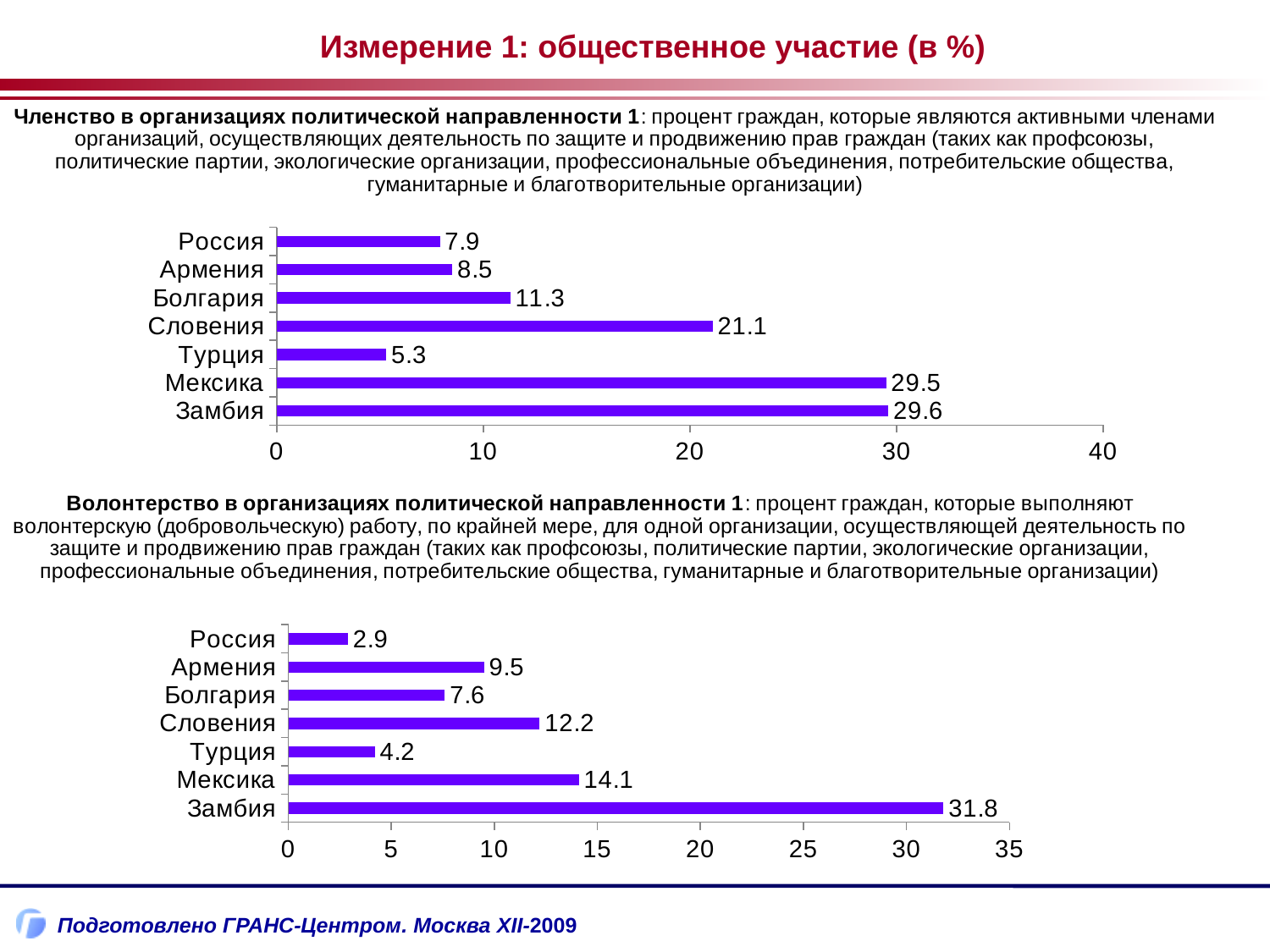
In the bottom chart (volunteering in political organizations), which country has the lowest value? Россия What is the maximum value shown on the x axis of the top chart (membership in political organizations)? 40 In the top chart (membership in political organizations), what is the difference between the values for Словения and Болгария? 9.8 In the top chart (membership in political organizations), which is larger: the value for Армения or the value for Россия? Армения In the bottom chart (volunteering in political organizations), what is the value for Мексика? 14.1 In the top chart (membership in political organizations), how many countries are shown? 7 In the bottom chart (volunteering in political organizations), which country has the highest value? Замбия In the bottom chart (volunteering in political organizations), what is the difference between the values for Замбия and Мексика? 17.7 In the top chart (membership in political organizations), what is the value for Словения? 21.1 In the bottom chart (volunteering in political organizations), is the value for Словения greater or less than 10? greater What type of chart is the bottom chart (volunteering in political organizations)? bar chart In the top chart (membership in political organizations), which country has the lowest value? Турция